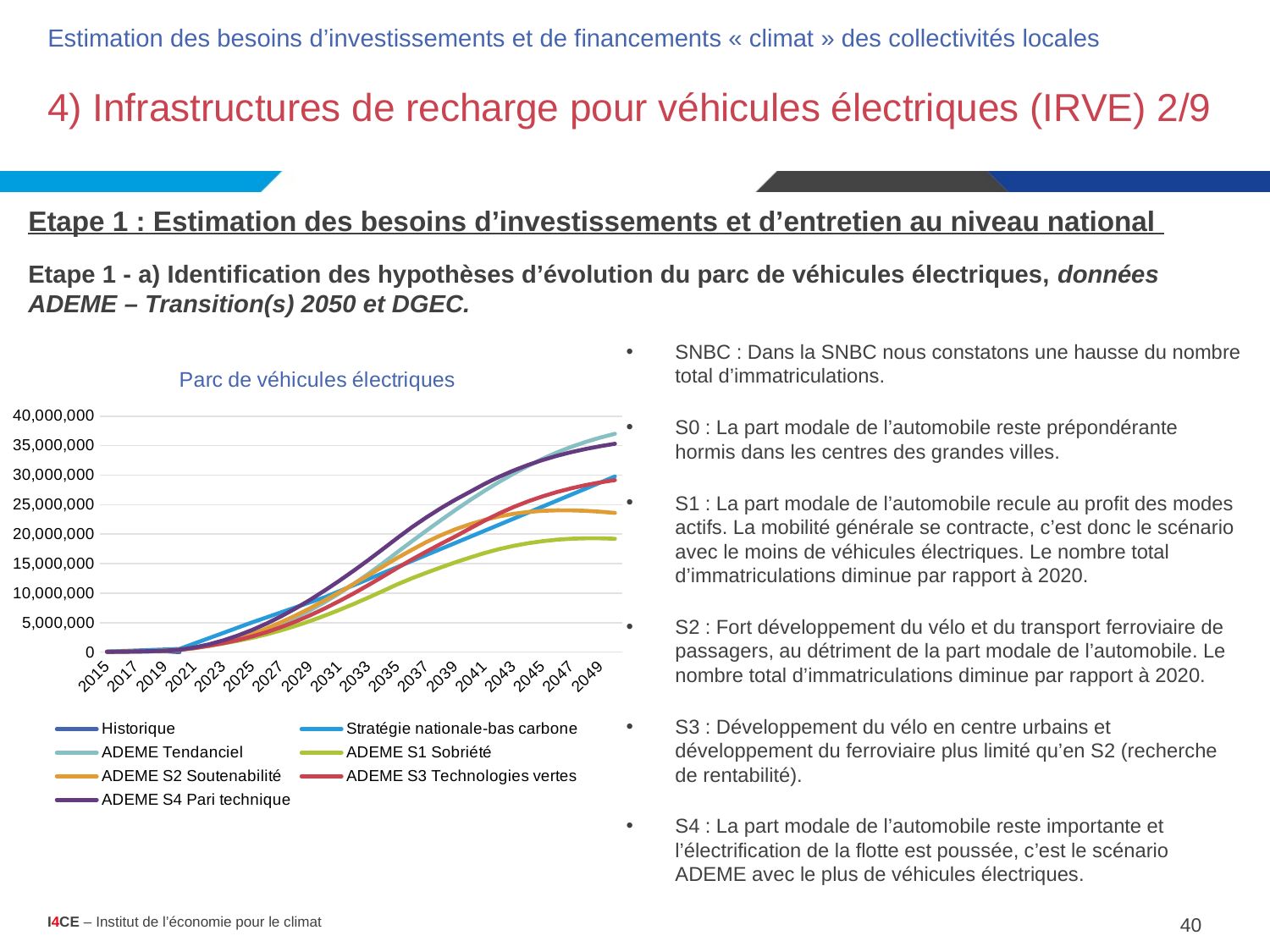
What is the title of the chart? Parc de véhicules électriques Is the value for ADEME S1 Sobriété in 2049 greater or less than 25,000,000? less Is the value for ADEME Tendanciel in 2049 greater or less than 35,000,000? greater Is the value for ADEME S4 Pari technique in 2049 greater or less than 30,000,000? greater Which series has the highest value in 2049? ADEME Tendanciel What kind of chart is shown on the slide? line chart In 2049, which is larger: ADEME S4 Pari technique or ADEME S1 Sobriété? ADEME S4 Pari technique What colour is the ADEME S4 Pari technique line in the legend? purple How many series does the chart legend list? 7 Do the values of the ADEME S4 Pari technique series rise or fall from 2021 to 2049? rise Which series has the lowest value in 2049? ADEME S1 Sobriété